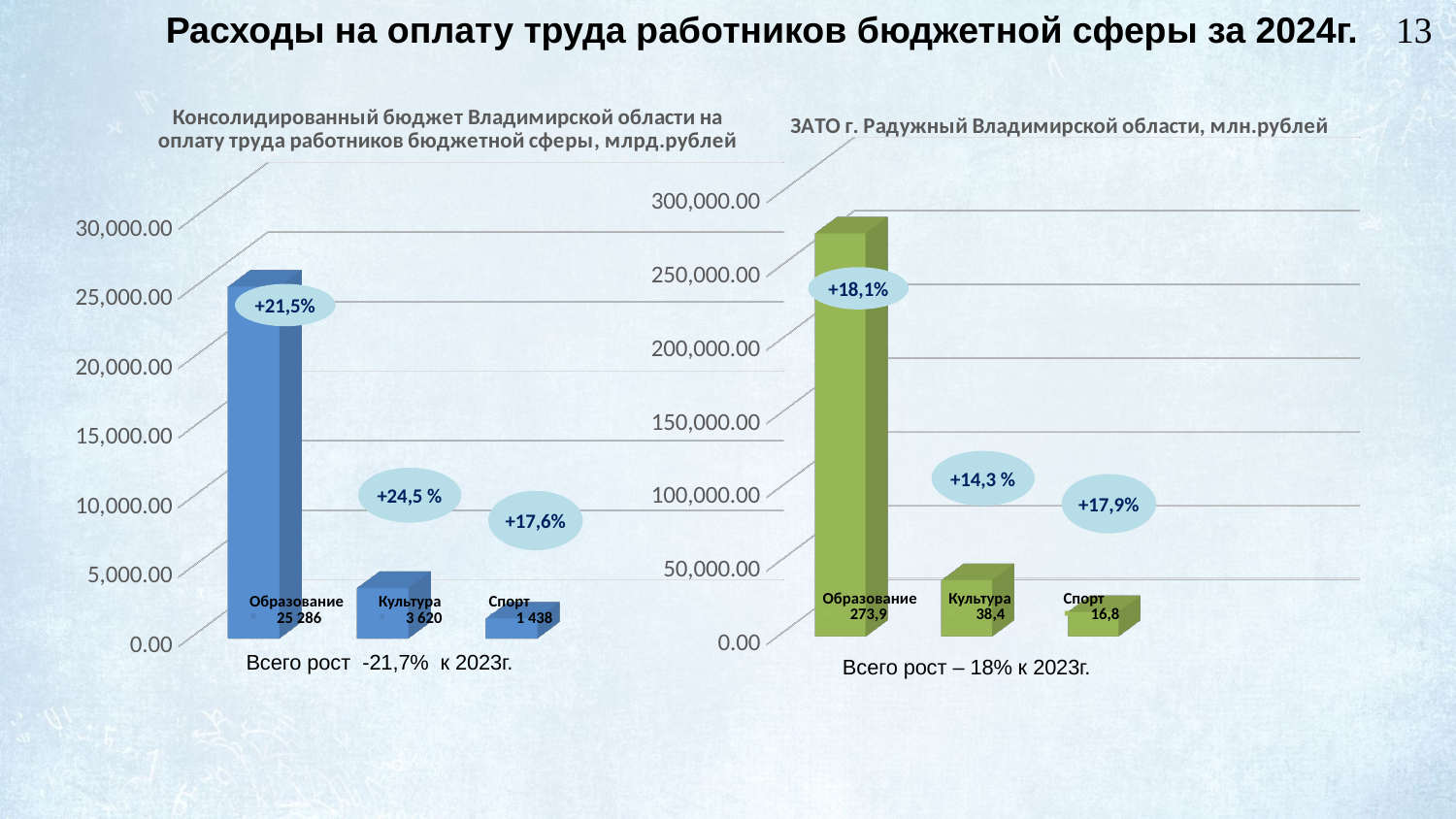
What type of chart is the left chart (Консолидированный бюджет Владимирской области)? Bar chart In the left chart (Консолидированный бюджет Владимирской области), which category has the lowest value? Спорт In the left chart (Консолидированный бюджет Владимирской области), what is the value for Образование? 25 286 In the left chart (Консолидированный бюджет Владимирской области), what is the difference between the values for Образование and Культура? 21 666 In the right chart (ЗАТО г. Радужный), what is the value for Спорт? 16,8 In the right chart (ЗАТО г. Радужный), which is larger, the value for Культура or the value for Спорт? Культура How many categories are shown in the right chart (ЗАТО г. Радужный)? 3 In the left chart (Консолидированный бюджет Владимирской области), what is the value for Культура? 3 620 In the right chart (ЗАТО г. Радужный), which category has the highest value? Образование In the right chart (ЗАТО г. Радужный), what is the difference between the values for Образование and Культура? 235,5 In the right chart (ЗАТО г. Радужный), what is the value for Образование? 273,9 In the left chart (Консолидированный бюджет Владимирской области), is the bar for Образование greater or less than 20,000.00 on the axis? greater